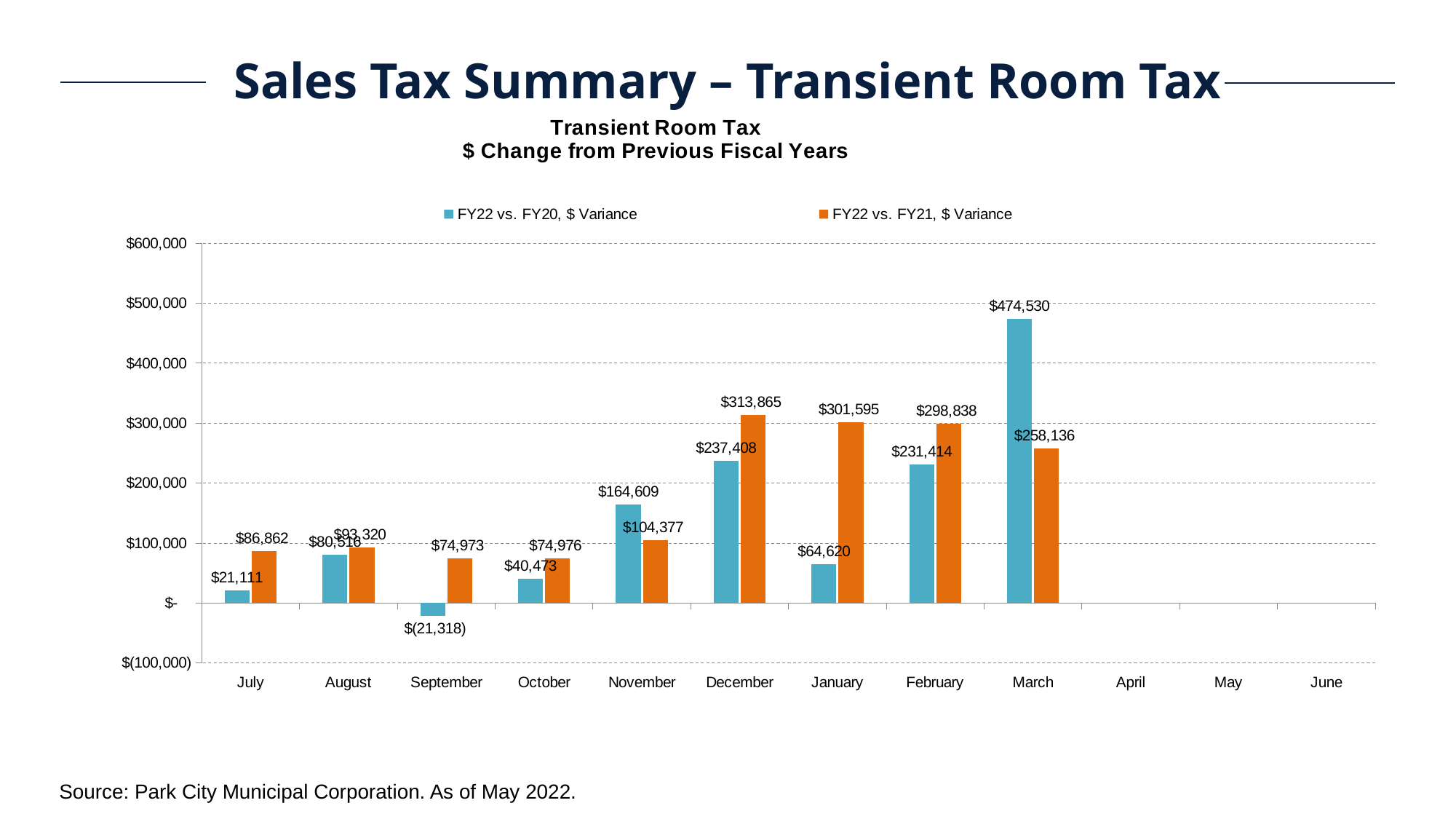
Which month has the lowest FY22 vs. FY20 $ Variance? September In January, which series has the larger value: FY22 vs. FY20 or FY22 vs. FY21? FY22 vs. FY21 What kind of chart is shown on the slide? bar chart How many series does the legend list? 2 Is the FY22 vs. FY20 $ Variance for November greater or less than $100,000? greater How many months are listed on the x axis? 12 What is the FY22 vs. FY21 $ Variance for December? $313,865 Which month has the highest FY22 vs. FY20 $ Variance? March What is the difference between the FY22 vs. FY20 and FY22 vs. FY21 $ Variance values for March? $216,394 What is the FY22 vs. FY20 $ Variance for September? $(21,318) Which month has the highest FY22 vs. FY21 $ Variance? December What is the FY22 vs. FY20 $ Variance for March? $474,530